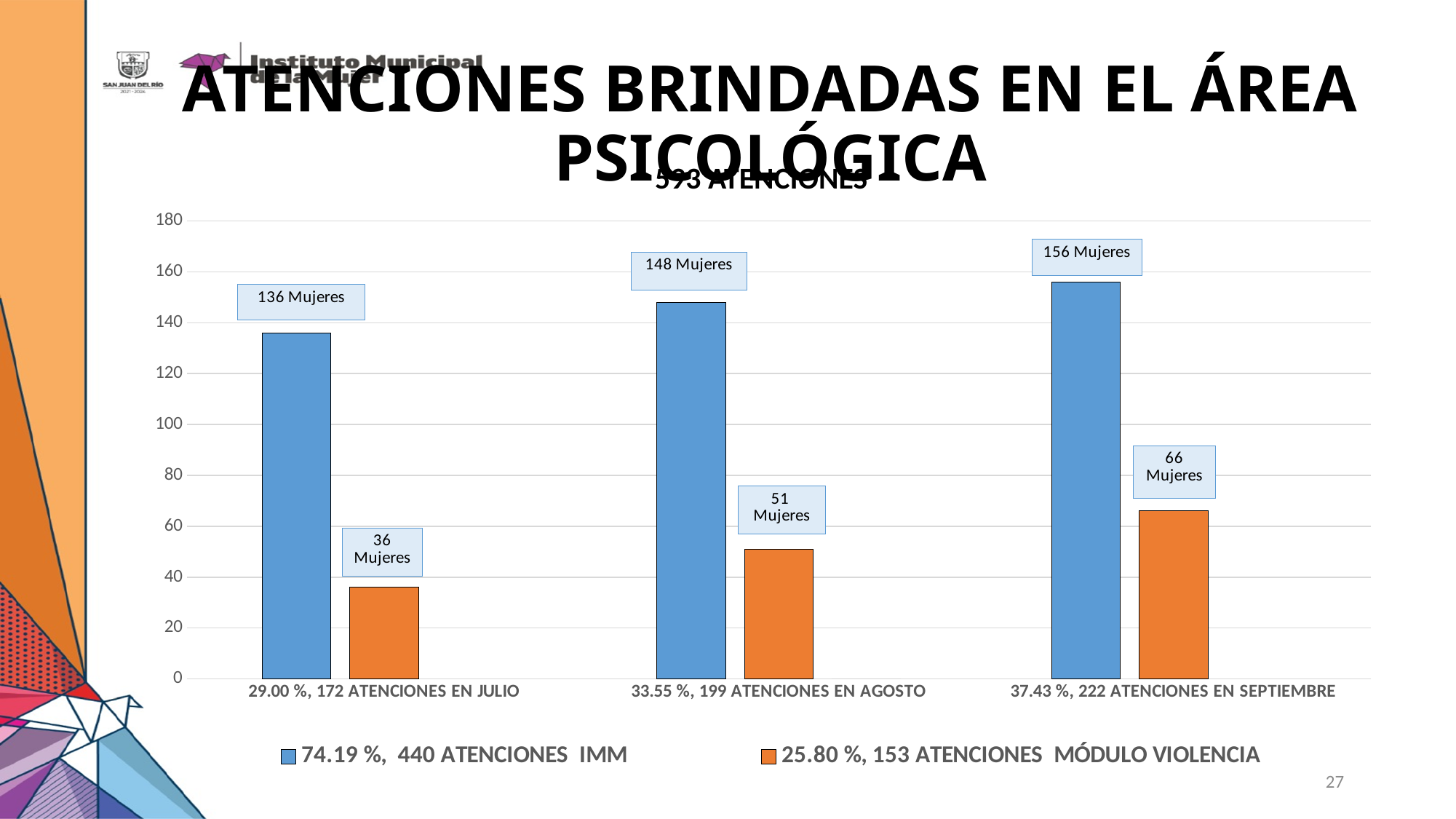
What is the value for the MÓDULO VIOLENCIA series in the category '33.55 %, 199 ATENCIONES EN AGOSTO'? 51 Mujeres How many categories are shown on the x axis? 3 Is the IMM value for Agosto greater or less than 140? greater What kind of chart is shown on the slide? bar chart What is the value for the IMM series in the category '29.00 %, 172 ATENCIONES EN JULIO'? 136 Mujeres How many series does the legend list? 2 Do the MÓDULO VIOLENCIA values rise or fall from Julio to Septiembre? rise What is the value for the IMM series in the category '37.43 %, 222 ATENCIONES EN SEPTIEMBRE'? 156 Mujeres In which category is the MÓDULO VIOLENCIA series highest? 37.43 %, 222 ATENCIONES EN SEPTIEMBRE What is the difference between the IMM value and the MÓDULO VIOLENCIA value in the Septiembre category? 90 In which category is the IMM series lowest? 29.00 %, 172 ATENCIONES EN JULIO Which is larger: the MÓDULO VIOLENCIA value in Julio or the MÓDULO VIOLENCIA value in Agosto? Agosto